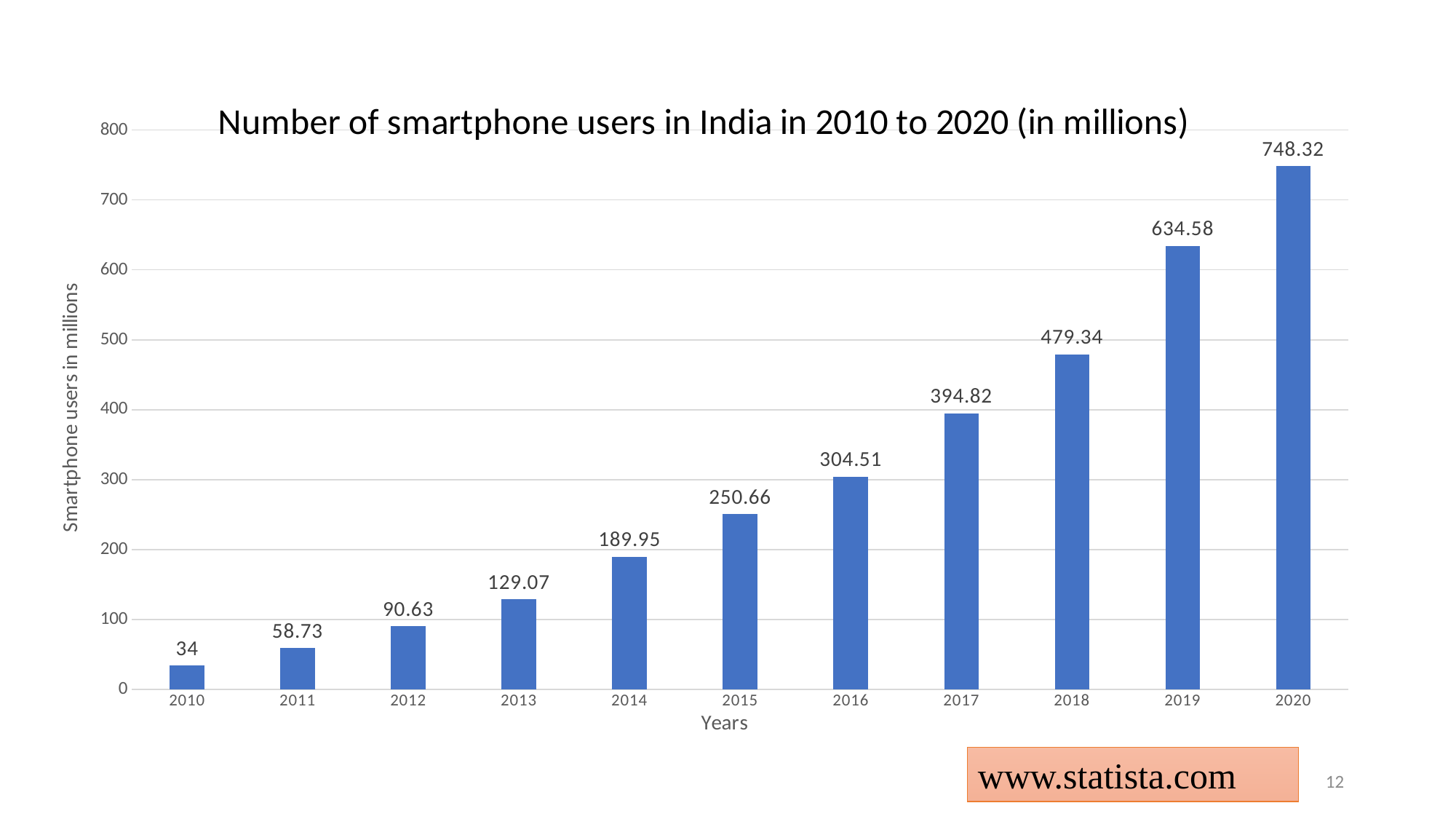
What is the difference between the values for 2020 and 2019? 113.74 What kind of chart is shown on the slide? Bar chart Do the values rise or fall from 2010 to 2020? Rise What is the difference between the values for 2014 and 2013? 60.88 What is the value shown for 2010? 34 What is the number of smartphone users in India in 2015? 250.66 What is the value shown for 2018? 479.34 How many years are shown on the x axis? 11 Which is larger, the value for 2016 or the value for 2017? 2017 Which year has the lowest number of smartphone users? 2010 Is the value for 2019 greater or less than 600? greater Which year has the highest number of smartphone users? 2020